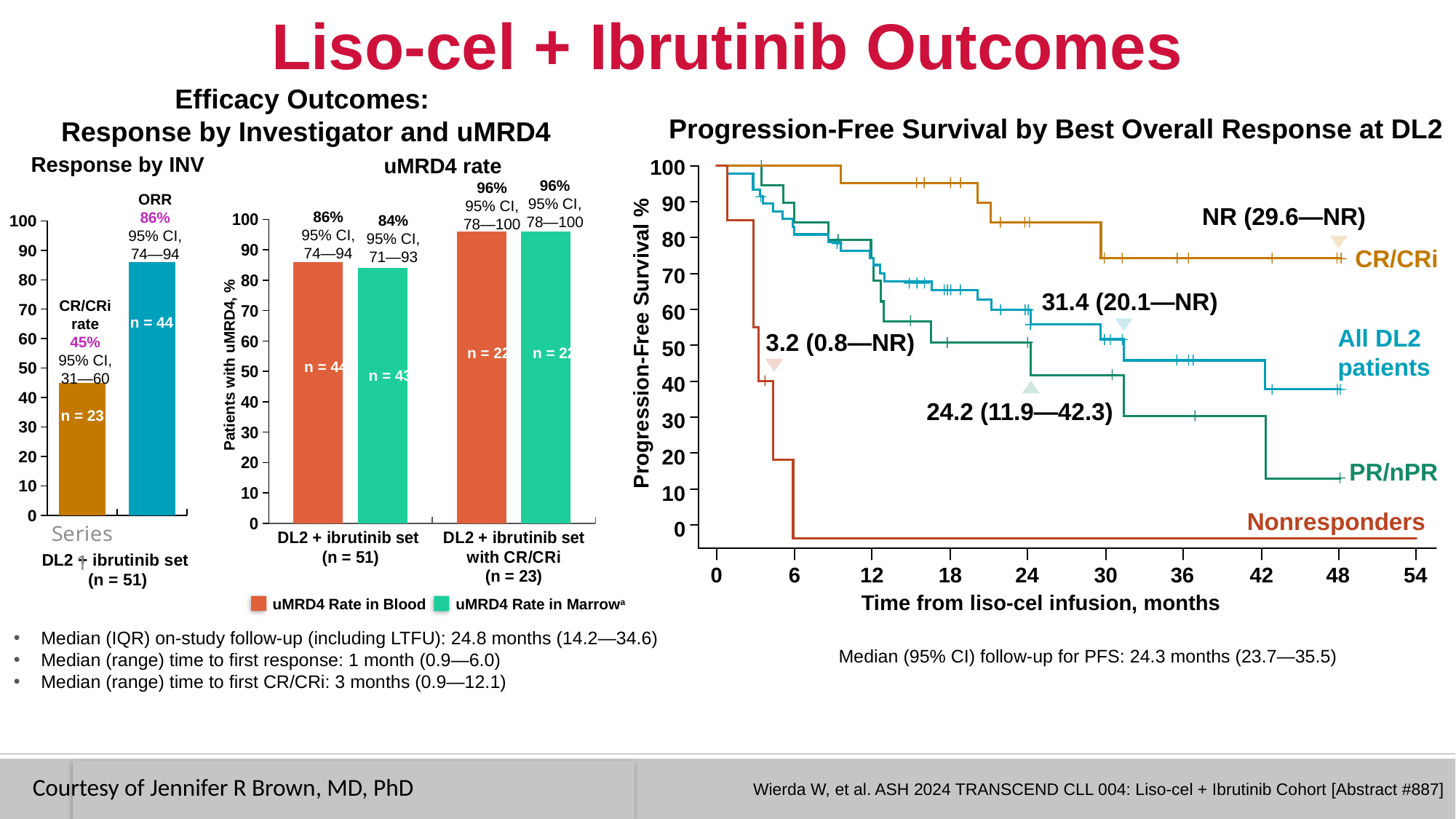
In the uMRD4 rate chart, how many series does the legend list? 2 In the uMRD4 rate chart, what is the uMRD4 rate in blood for the DL2 + ibrutinib set with CR/CRi (n = 23)? 96% In the uMRD4 rate chart, what is the uMRD4 rate in marrow for the DL2 + ibrutinib set (n = 51)? 84% In the Progression-Free Survival chart, what is the median PFS (95% CI) for Nonresponders? 3.2 (0.8—NR) In the Response by INV chart, how many patients does the CR/CRi bar represent? n = 23 In the Response by INV chart, what is the CR/CRi rate? 45% In the Progression-Free Survival chart, is the CR/CRi curve at 48 months greater or less than 70%? greater In the uMRD4 rate chart, which is larger for the DL2 + ibrutinib set (n = 51): the uMRD4 rate in blood or in marrow? uMRD4 rate in blood In the Progression-Free Survival chart, what is the median PFS (95% CI) for PR/nPR patients? 24.2 (11.9—42.3) What kind of chart is the uMRD4 rate chart? Bar chart In the Response by INV chart, what is the ORR? 86% In the Response by INV chart, what is the difference between the ORR and the CR/CRi rate? 41%